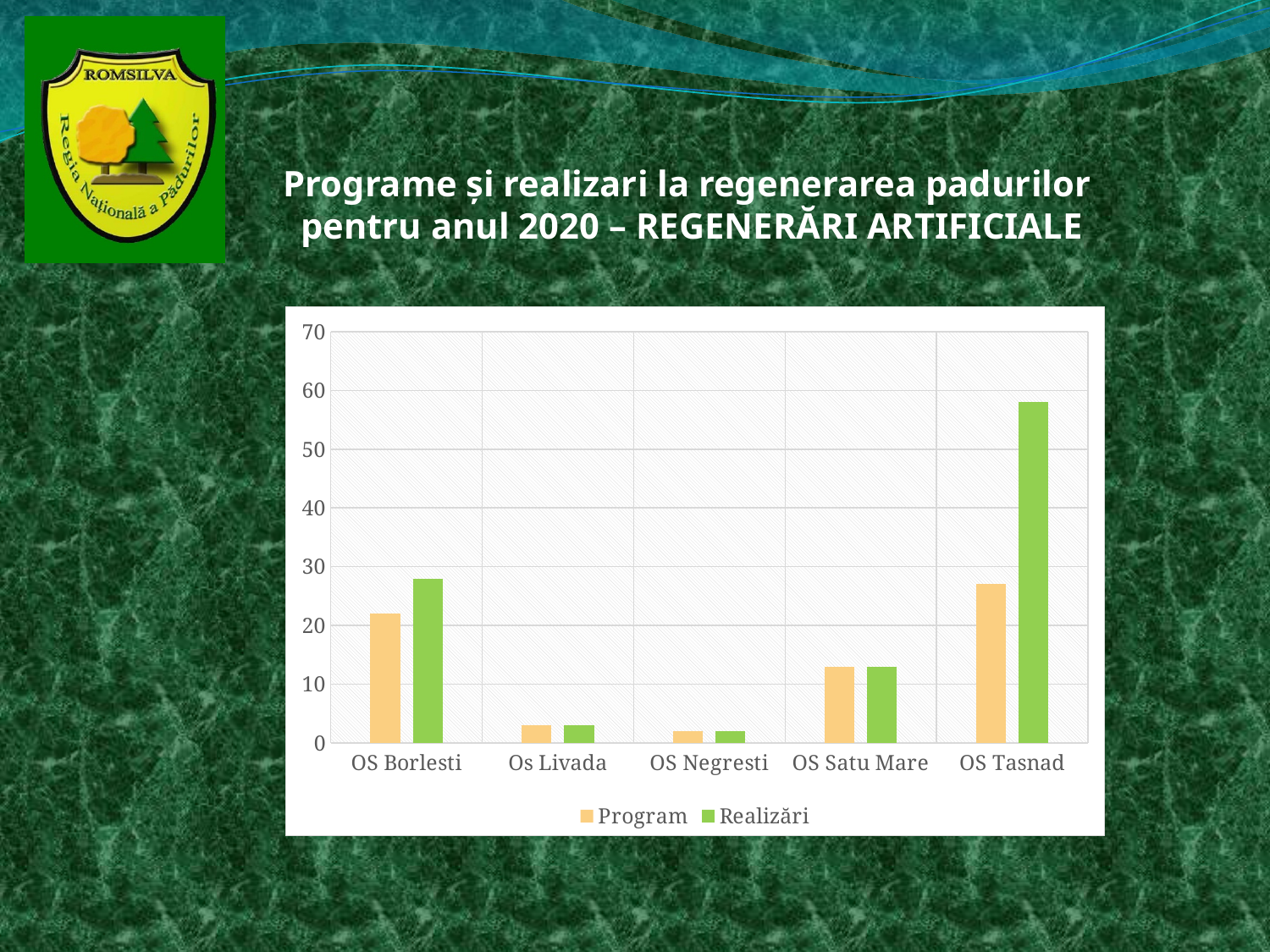
How many series does the legend list? 2 Is the Program value for OS Borlesti greater or less than 30? less What kind of chart is shown on the slide? bar chart For OS Tasnad, which is larger: Program or Realizări? Realizări Is the Realizări value for OS Tasnad greater or less than 50? greater Which category has the lowest Program value? OS Negresti Is the Realizări value for OS Satu Mare greater or less than 10? greater What are the two series named in the legend? Program and Realizări Which category has the highest Realizări value? OS Tasnad How many categories are shown on the x axis? 5 Which category has the highest Program value? OS Tasnad